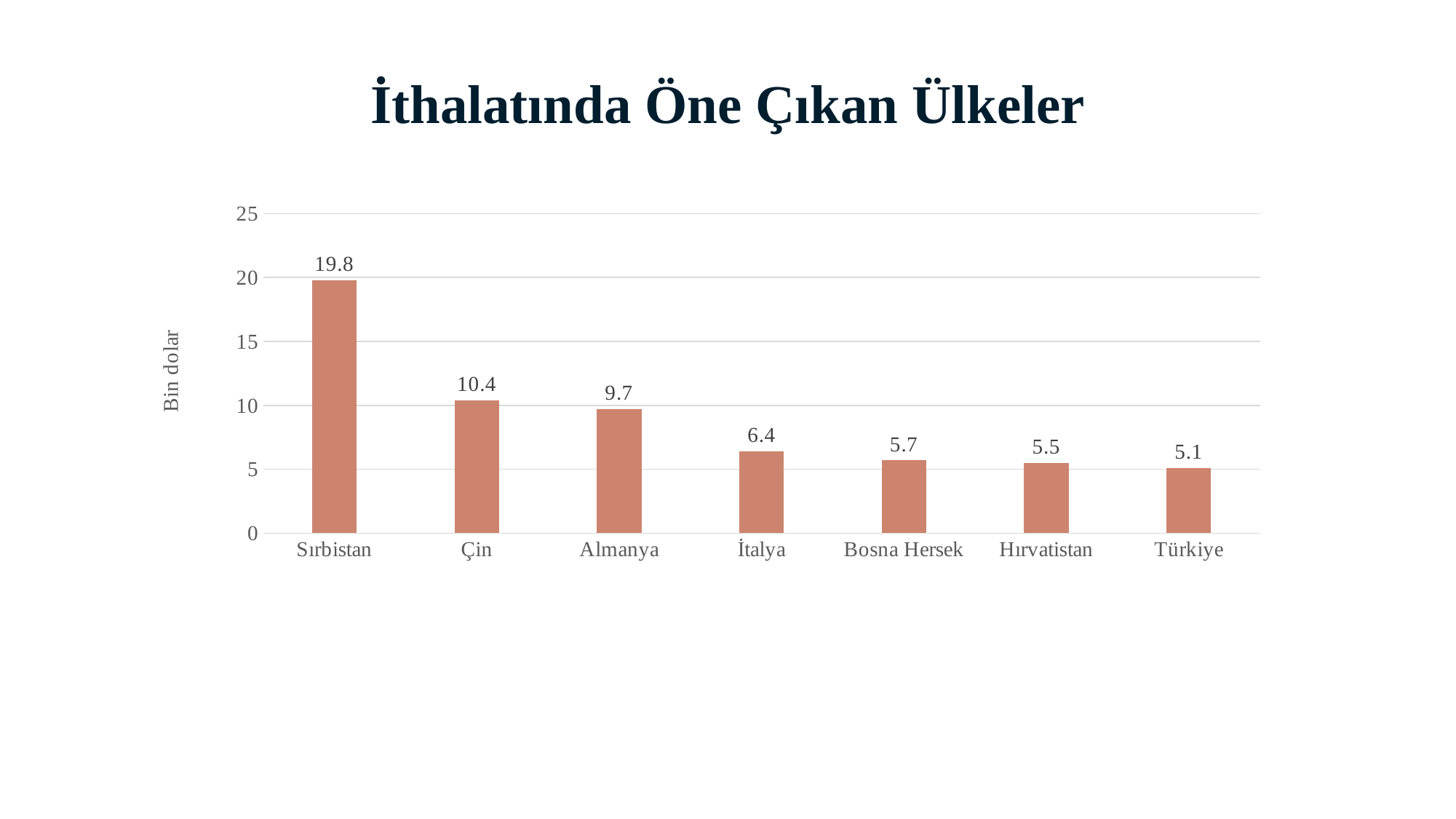
How many countries are shown in the chart? 7 Which is larger, the value for Çin or the value for Almanya? Çin What is the value for Sırbistan? 19.8 What is the value for Almanya? 9.7 What is the difference between the values for Sırbistan and Çin? 9.4 What is the value for Türkiye? 5.1 Which country has the highest value? Sırbistan What is the title of the chart? İthalatında Öne Çıkan Ülkeler Which country has the lowest value? Türkiye Is the value for Sırbistan greater or less than 15? greater What kind of chart is shown on the slide? bar chart What is the difference between the values for İtalya and Bosna Hersek? 0.7